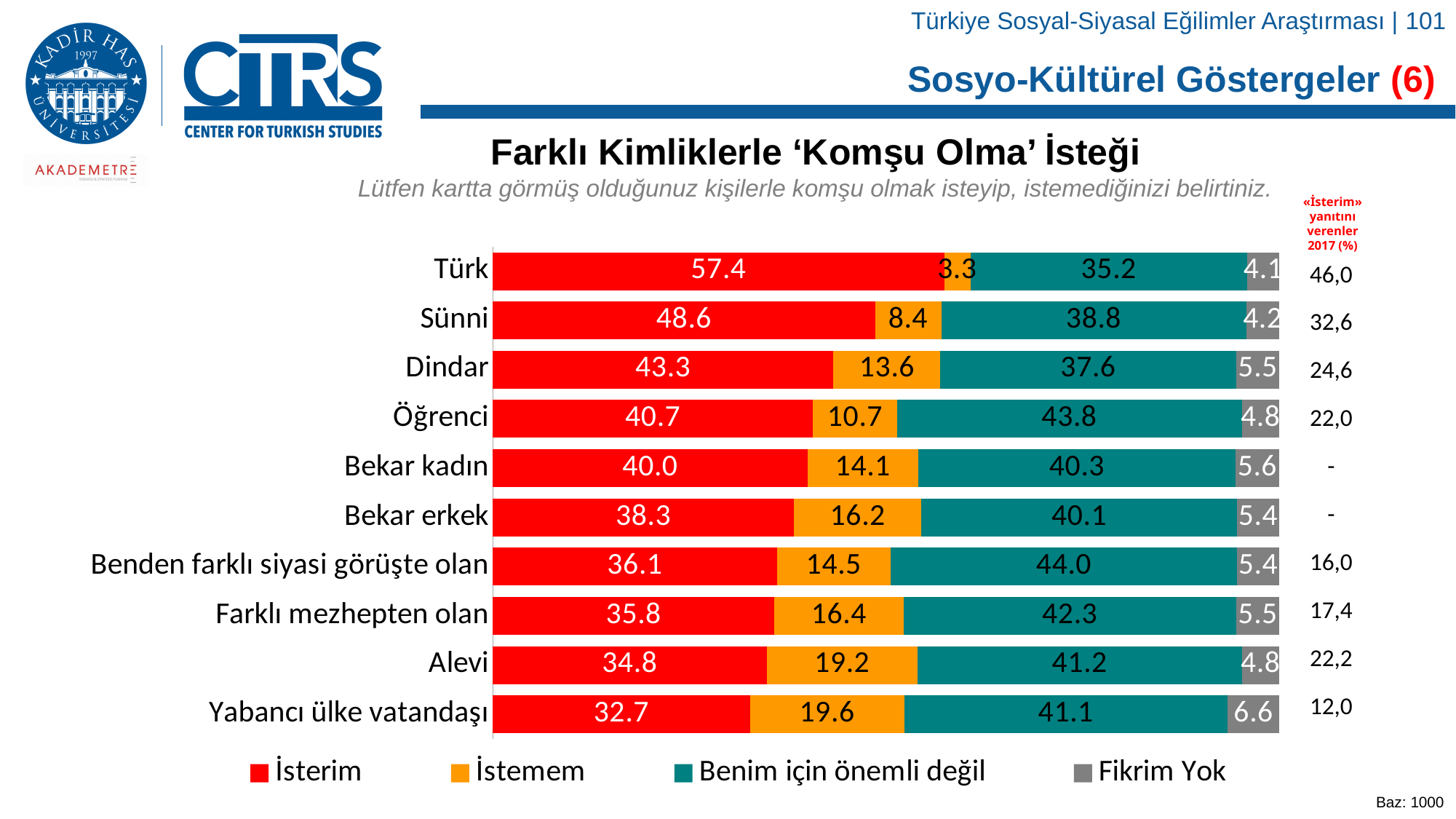
What is the total of the stacked bar for Alevi? 100.0 Which category has the lowest 'İsterim' value? Yabancı ülke vatandaşı What is the 'Fikrim Yok' value for Yabancı ülke vatandaşı? 6.6 How many series does the legend list? 4 How many categories are shown in the chart? 10 Which category has the highest 'İsterim' value? Türk What kind of chart is shown on the slide? Stacked bar chart Which has the larger 'İstemem' value, Bekar kadın or Bekar erkek? Bekar erkek What is the 'Benim için önemli değil' value for Öğrenci? 43.8 What is the difference between the 'İsterim' values for Türk and Sünni? 8.8 What is the title of the chart? Farklı Kimliklerle ‘Komşu Olma’ İsteği What is the 'İsterim' value for Dindar? 43.3